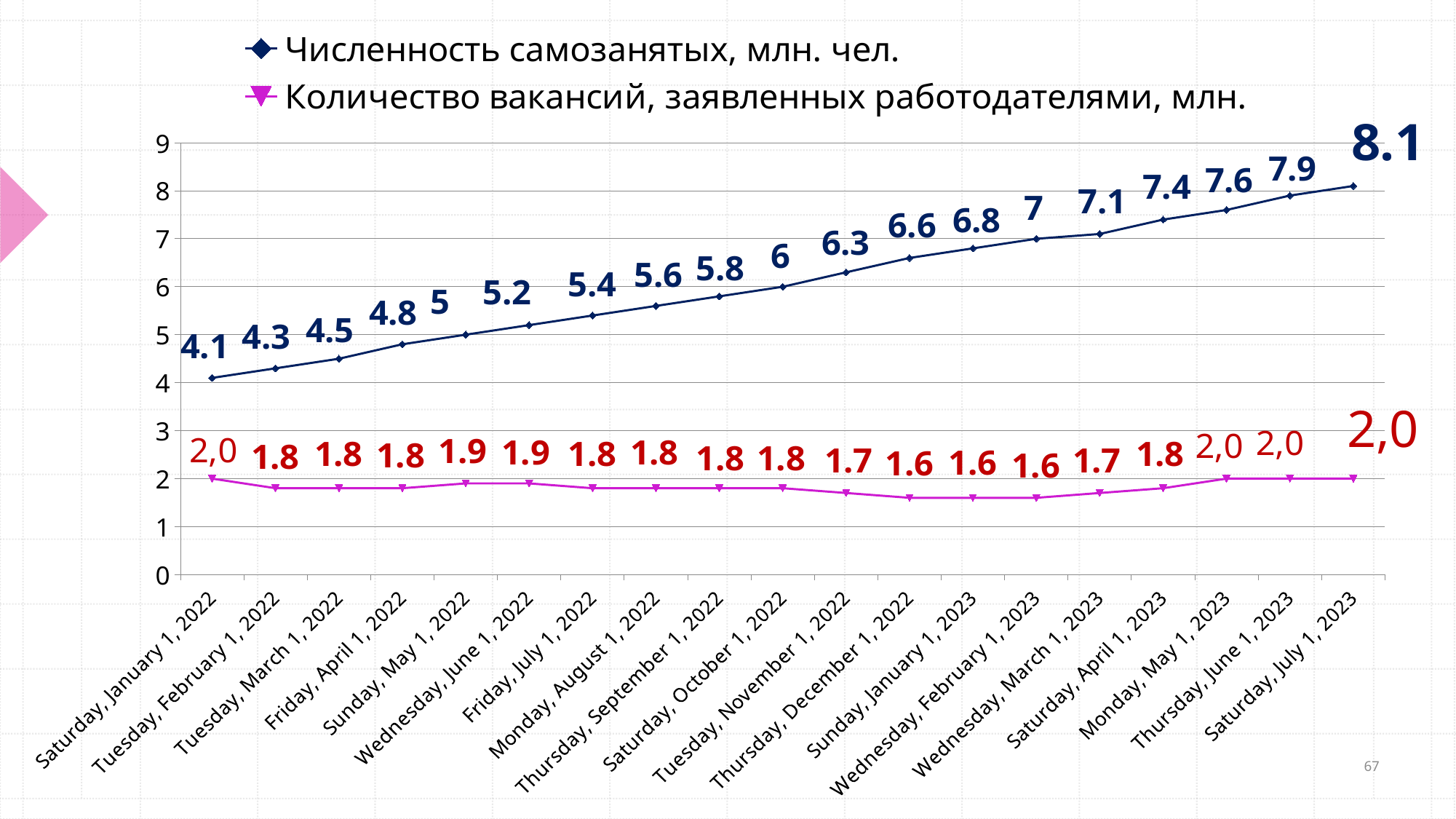
Which series has the larger value on Friday, July 1, 2022: "Численность самозанятых, млн. чел." or "Количество вакансий, заявленных работодателями, млн."? Численность самозанятых, млн. чел. At which date does "Численность самозанятых, млн. чел." reach its highest value? Saturday, July 1, 2023 What type of chart is shown on the slide? line chart Does "Численность самозанятых, млн. чел." rise or fall from January 2022 to July 2023? rise How many data points does each series have along the x axis? 19 What is the value of "Численность самозанятых, млн. чел." on Saturday, July 1, 2023? 8.1 What is the value of "Численность самозанятых, млн. чел." on Saturday, October 1, 2022? 6 How many series does the legend list? 2 What is the difference between the "Численность самозанятых, млн. чел." values on Saturday, July 1, 2023 and Saturday, January 1, 2022? 4 What is the value of "Численность самозанятых, млн. чел." on Saturday, January 1, 2022? 4.1 What is the value of "Количество вакансий, заявленных работодателями, млн." on Sunday, January 1, 2023? 1.6 What is the lowest value shown for "Количество вакансий, заявленных работодателями, млн."? 1.6